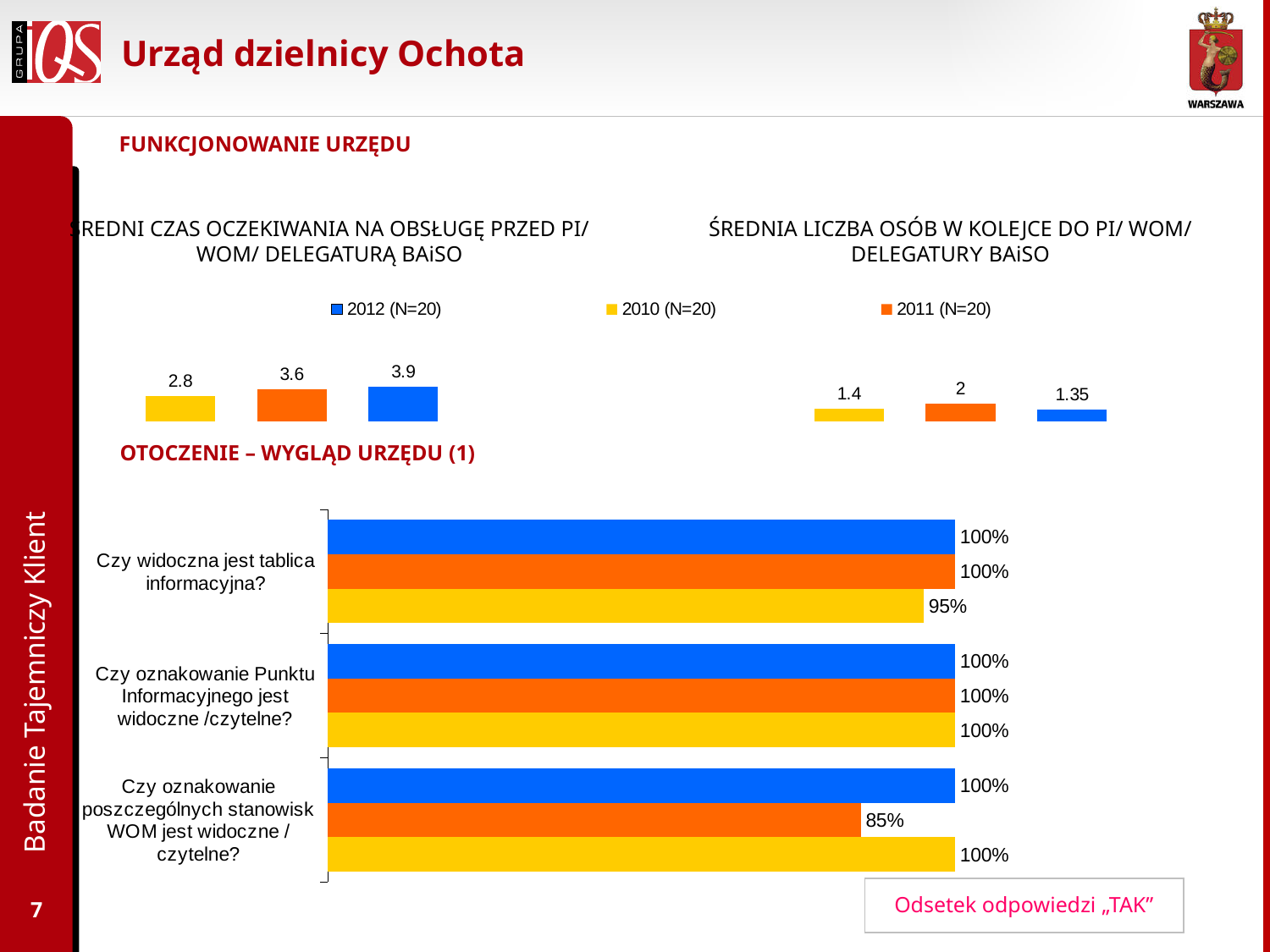
In the chart 'ŚREDNIA LICZBA OSÓB W KOLEJCE DO PI/ WOM/ DELEGATURY BAiSO', what is the value for 2011? 2 What type of chart is the bottom chart 'OTOCZENIE – WYGLĄD URZĘDU (1)'? bar chart How many series does the shared legend list? 3 In the chart 'ŚREDNI CZAS OCZEKIWANIA NA OBSŁUGĘ PRZED PI/ WOM/ DELEGATURĄ BAiSO', what is the value for 2012? 3.9 In the chart 'ŚREDNI CZAS OCZEKIWANIA NA OBSŁUGĘ PRZED PI/ WOM/ DELEGATURĄ BAiSO', what is the value for 2010? 2.8 In the chart 'ŚREDNIA LICZBA OSÓB W KOLEJCE DO PI/ WOM/ DELEGATURY BAiSO', is the value for 2010 larger or smaller than the value for 2011? smaller In the bottom chart 'OTOCZENIE – WYGLĄD URZĘDU (1)', what is the 2011 value for 'Czy oznakowanie poszczególnych stanowisk WOM jest widoczne / czytelne?'? 85% In the bottom chart 'OTOCZENIE – WYGLĄD URZĘDU (1)', how many question categories are shown? 3 In the bottom chart 'OTOCZENIE – WYGLĄD URZĘDU (1)', what is the 2010 value for 'Czy widoczna jest tablica informacyjna?'? 95% In the chart 'ŚREDNI CZAS OCZEKIWANIA NA OBSŁUGĘ PRZED PI/ WOM/ DELEGATURĄ BAiSO', which year has the highest value? 2012 In the chart 'ŚREDNIA LICZBA OSÓB W KOLEJCE DO PI/ WOM/ DELEGATURY BAiSO', which year has the lowest value? 2012 In the chart 'ŚREDNI CZAS OCZEKIWANIA NA OBSŁUGĘ PRZED PI/ WOM/ DELEGATURĄ BAiSO', what is the difference between the 2012 and 2010 values? 1.1